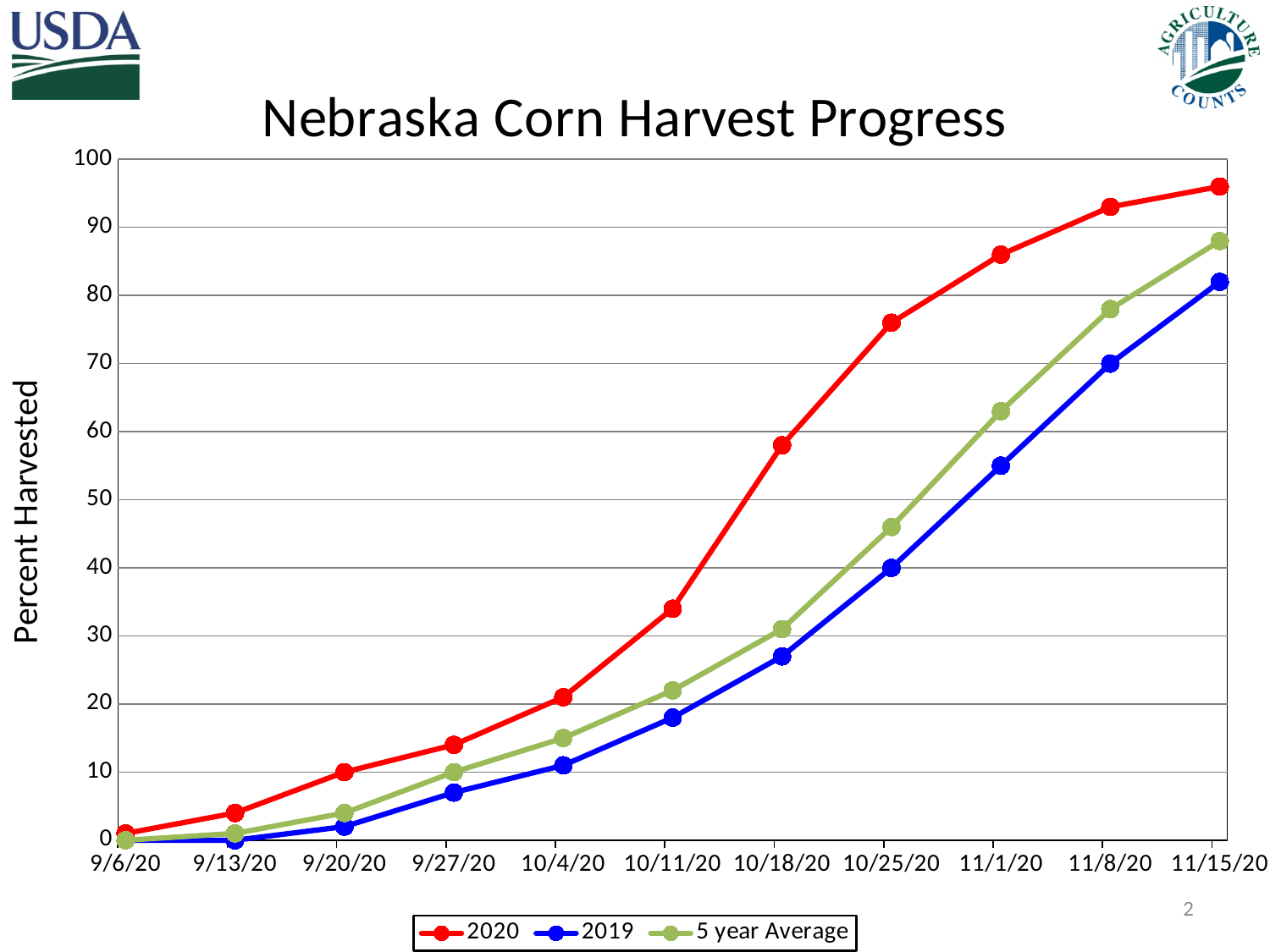
On 10/18/20, which is larger: the 2020 value or the 2019 value? 2020 Which series has the highest value on 11/15/20? 2020 How many series does the legend list? 3 Do the values for the 2020 series rise or fall from 9/6/20 to 11/15/20? Rise What is the title of the chart? Nebraska Corn Harvest Progress Is the 5 year Average value on 10/18/20 greater or less than 40? less How many dates are plotted along the x axis? 11 Is the 2019 value on 10/11/20 greater or less than 20? less What is the label on the vertical axis? Percent Harvested What kind of chart is shown on the slide? Line chart Which series has the lowest value on 11/1/20? 2019 Is the 2020 value on 10/25/20 greater or less than 70? greater